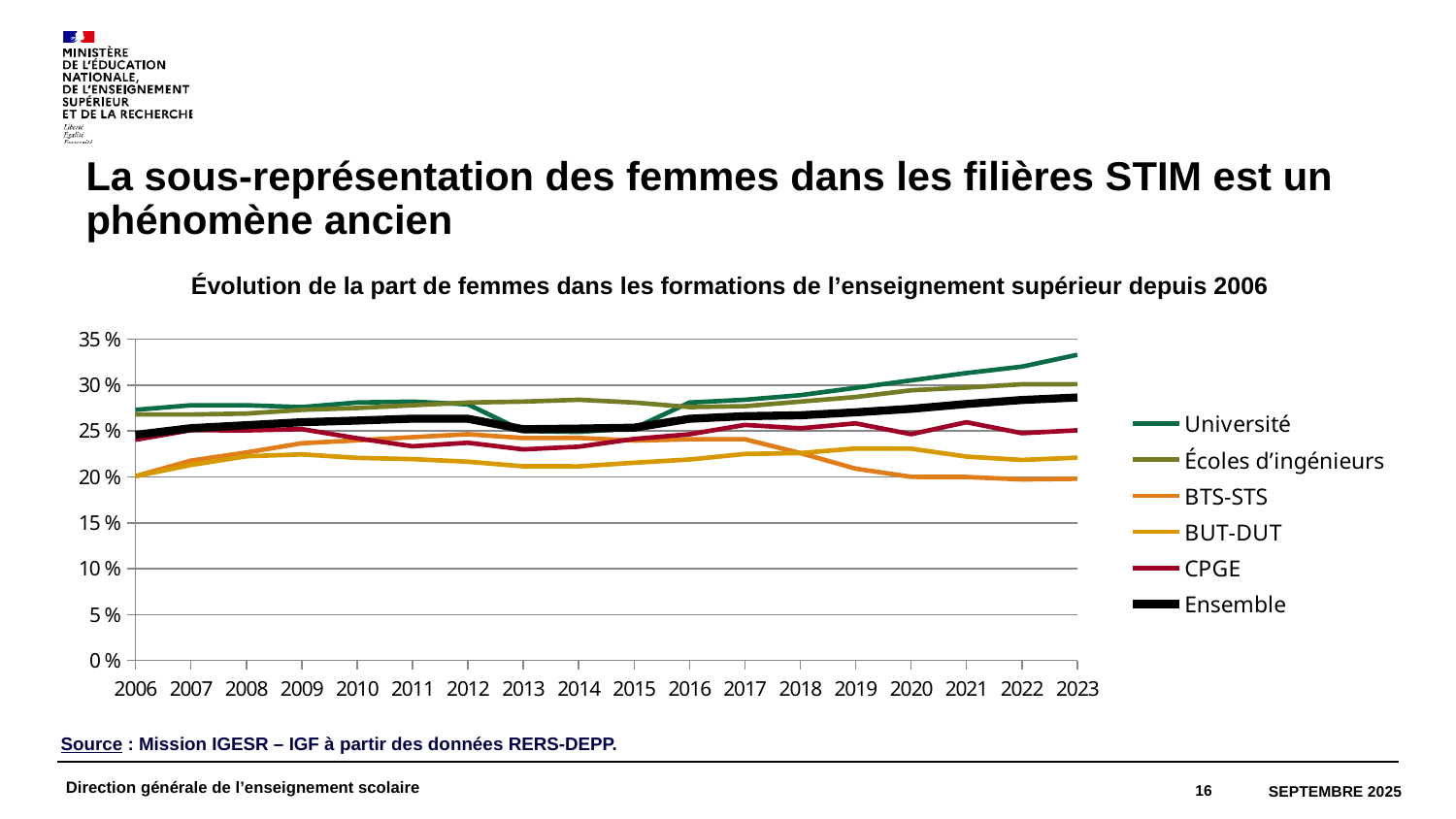
How many years are plotted along the x axis? 18 What is the title of the chart? Évolution de la part de femmes dans les formations de l'enseignement supérieur depuis 2006 How many series does the legend list? 6 Which series is drawn as the thick black line? Ensemble Does the Université series rise or fall between 2015 and 2023? Rise Which series has the highest value in 2023? Université What kind of chart is shown on the slide? Line chart Is the value for Université in 2023 greater or less than 30%? greater In 2023, which is larger: the value for Université or the value for BTS-STS? Université Is the value for Ensemble in 2023 greater or less than 25%? greater Is the value for BTS-STS in 2010 greater or less than 25%? less Which series has the lowest value in 2023? BTS-STS